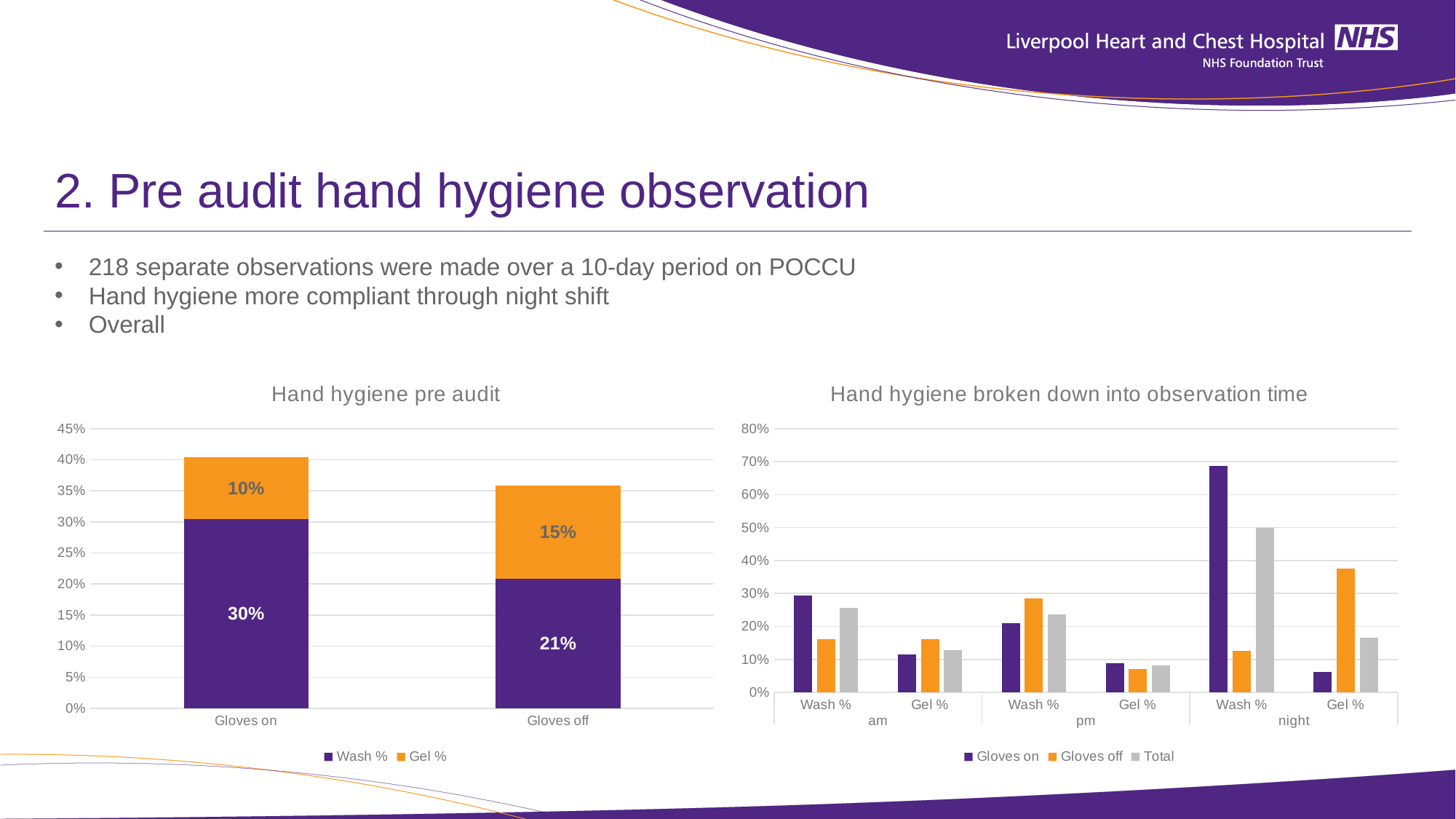
In the 'Hand hygiene pre audit' chart, how many series does the legend list? 2 In the 'Hand hygiene broken down into observation time' chart, is the Gloves on value for Wash % at night greater or less than 60%? greater In the 'Hand hygiene pre audit' chart, what is the total of the stacked bar for Gloves off? 36% In the 'Hand hygiene pre audit' chart, what is the difference between the Wash % values for Gloves on and Gloves off? 9% What kind of chart is 'Hand hygiene broken down into observation time'? Bar chart In the 'Hand hygiene broken down into observation time' chart, how many series does the legend list? 3 In the 'Hand hygiene broken down into observation time' chart, is the Gloves on value for Gel % in the pm greater or less than 10%? less In the 'Hand hygiene pre audit' chart, which category has the larger Gel % value, Gloves on or Gloves off? Gloves off In the 'Hand hygiene pre audit' chart, what is the Gel % value for Gloves off? 15% In the 'Hand hygiene pre audit' chart, what is the Gel % value for Gloves on? 10% In the 'Hand hygiene pre audit' chart, what is the Wash % value for Gloves on? 30% In the 'Hand hygiene broken down into observation time' chart, which observation time has the highest Gloves on value for Wash %? night